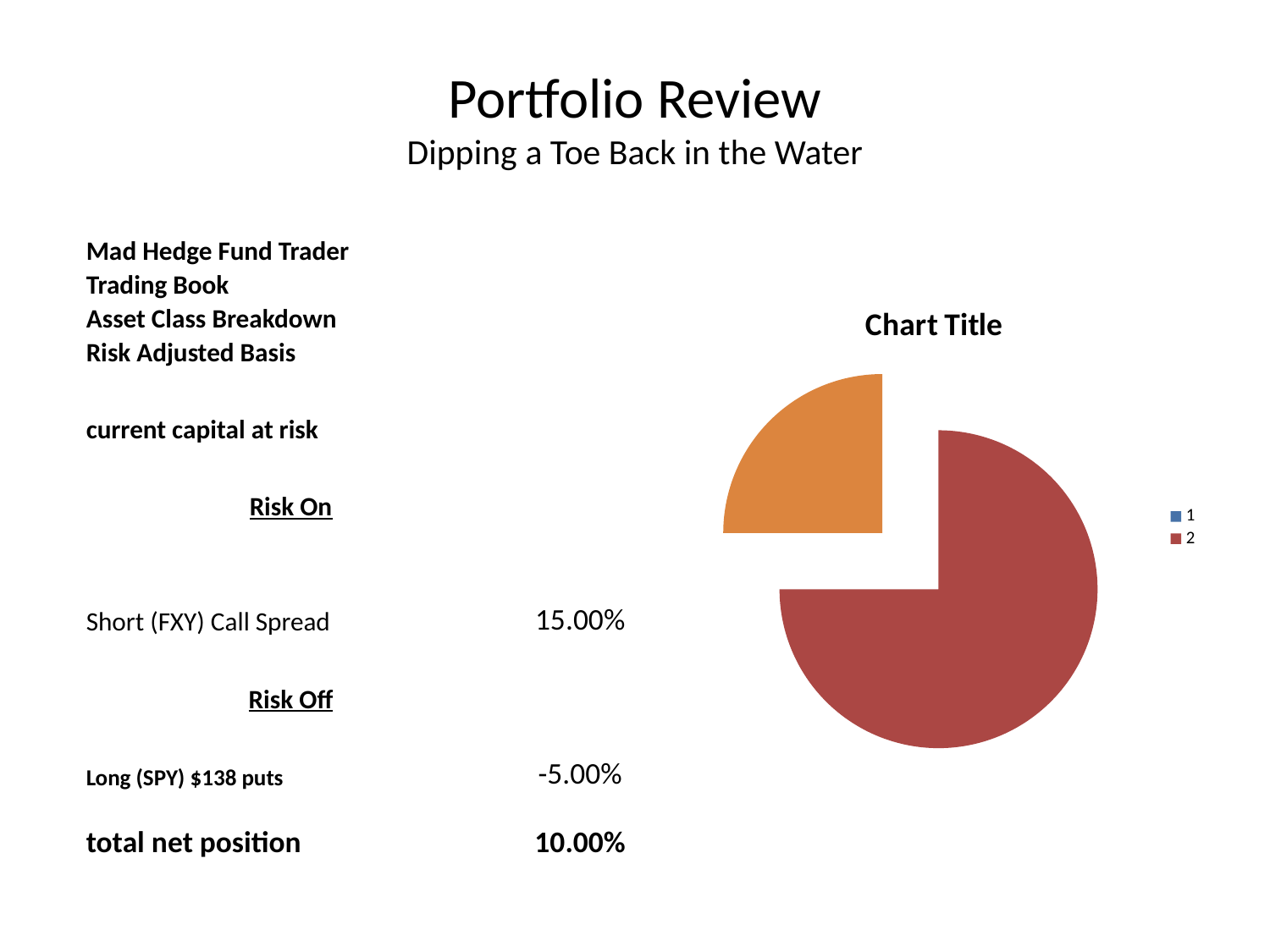
What colour is legend entry 2 in the chart's legend? red What kind of chart is shown on the slide? pie chart How many slices does the pie chart have? 2 Which slice of the pie chart is pulled out (exploded) from the rest of the pie, the red one or the orange one? the orange one How many entries does the chart's legend list? 2 What is the title of the chart on the slide? Chart Title Which slice of the pie chart is the smallest, the red one or the orange one? the orange one Is the red slice of the pie chart larger or smaller than the orange slice? larger Which slice of the pie chart is the largest, the red one or the orange one? the red one